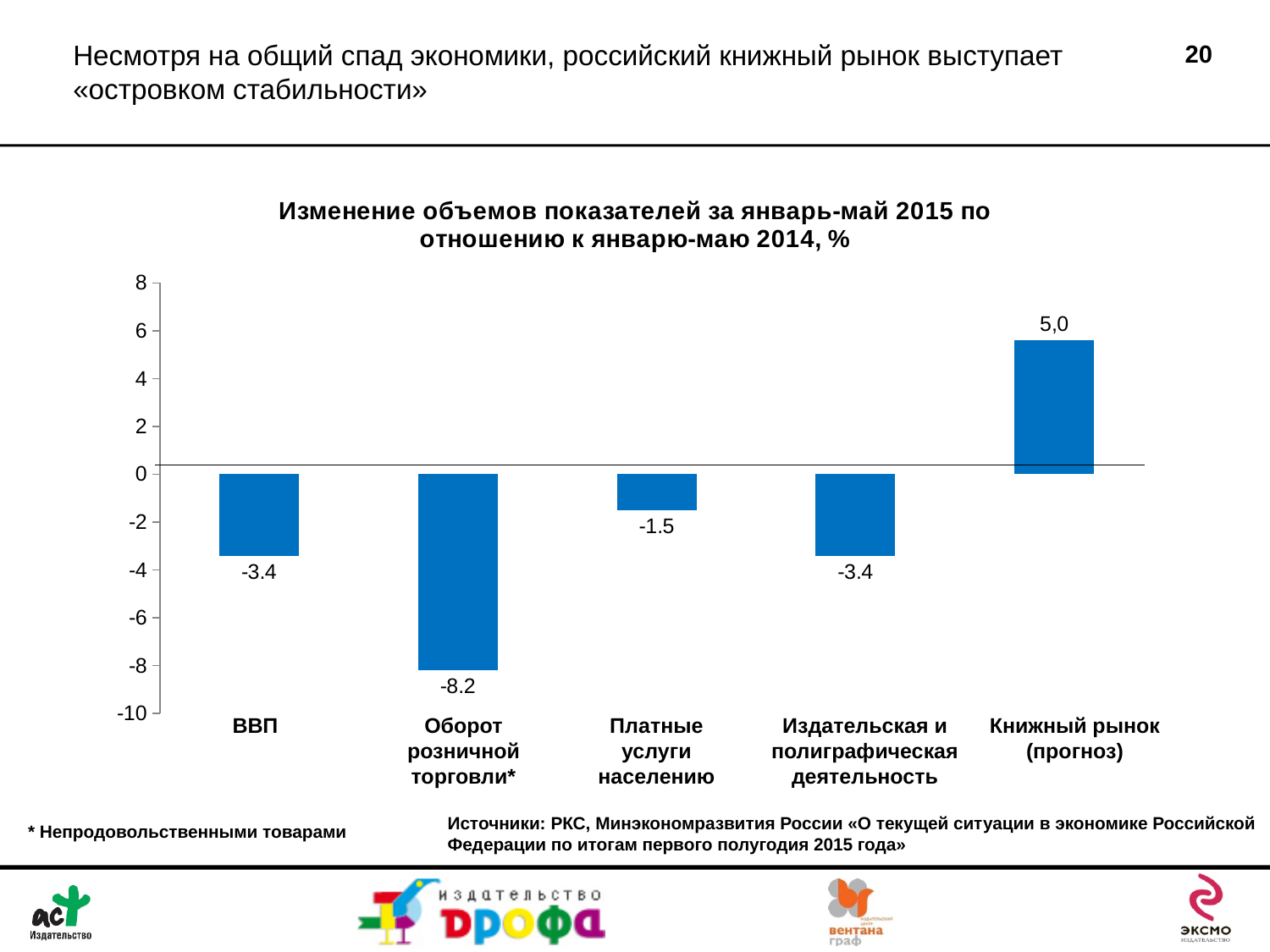
What is the value for Книжный рынок (прогноз)? 5,0 Which category has the highest value? Книжный рынок (прогноз) What is the title of the chart? Изменение объемов показателей за январь-май 2015 по отношению к январю-маю 2014, % What is the value for Платные услуги населению? -1.5 What is the value for Оборот розничной торговли*? -8.2 What is the value for ВВП? -3.4 Which category has the lowest value? Оборот розничной торговли* Which is larger, the value for ВВП or the value for Платные услуги населению? Платные услуги населению How many categories are shown on the x axis? 5 What kind of chart is shown on the slide? bar chart Is the value for Книжный рынок (прогноз) greater or less than 4? greater What is the difference between the values for Платные услуги населению and Оборот розничной торговли*? 6.7